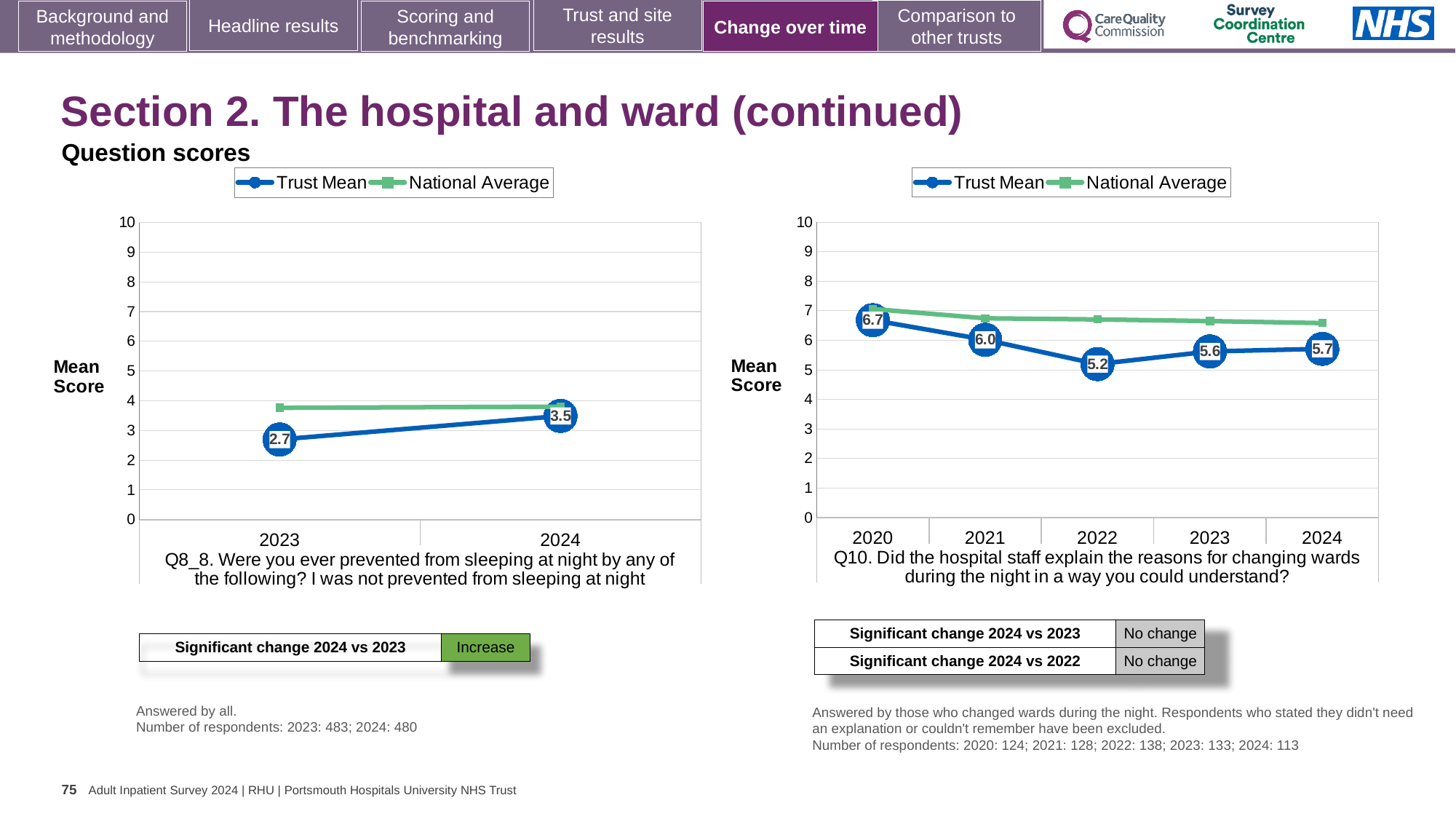
In the Q8_8 chart on the left, by how much did the Trust Mean change from 2023 to 2024? 0.8 In the Q10 chart on the right, which year has the highest Trust Mean? 2020 In the Q10 chart on the right, what is the difference between the Trust Mean in 2020 and in 2024? 1.0 In the Q8_8 chart on the left, is the National Average for 2023 greater or less than 3? greater In the Q10 chart on the right, what is the Trust Mean for 2020? 6.7 In the Q8_8 chart on the left, what is the Trust Mean for 2024? 3.5 In the Q8_8 chart on the left, what is the Trust Mean for 2023? 2.7 What type of chart is used for the Q10 chart on the right? line chart In the Q8_8 chart on the left, does the Trust Mean rise or fall from 2023 to 2024? rise In the Q10 chart on the right, which year has the lowest Trust Mean? 2022 In the Q10 chart on the right, what is the Trust Mean for 2022? 5.2 In the Q10 chart on the right, how many years are plotted on the x axis? 5